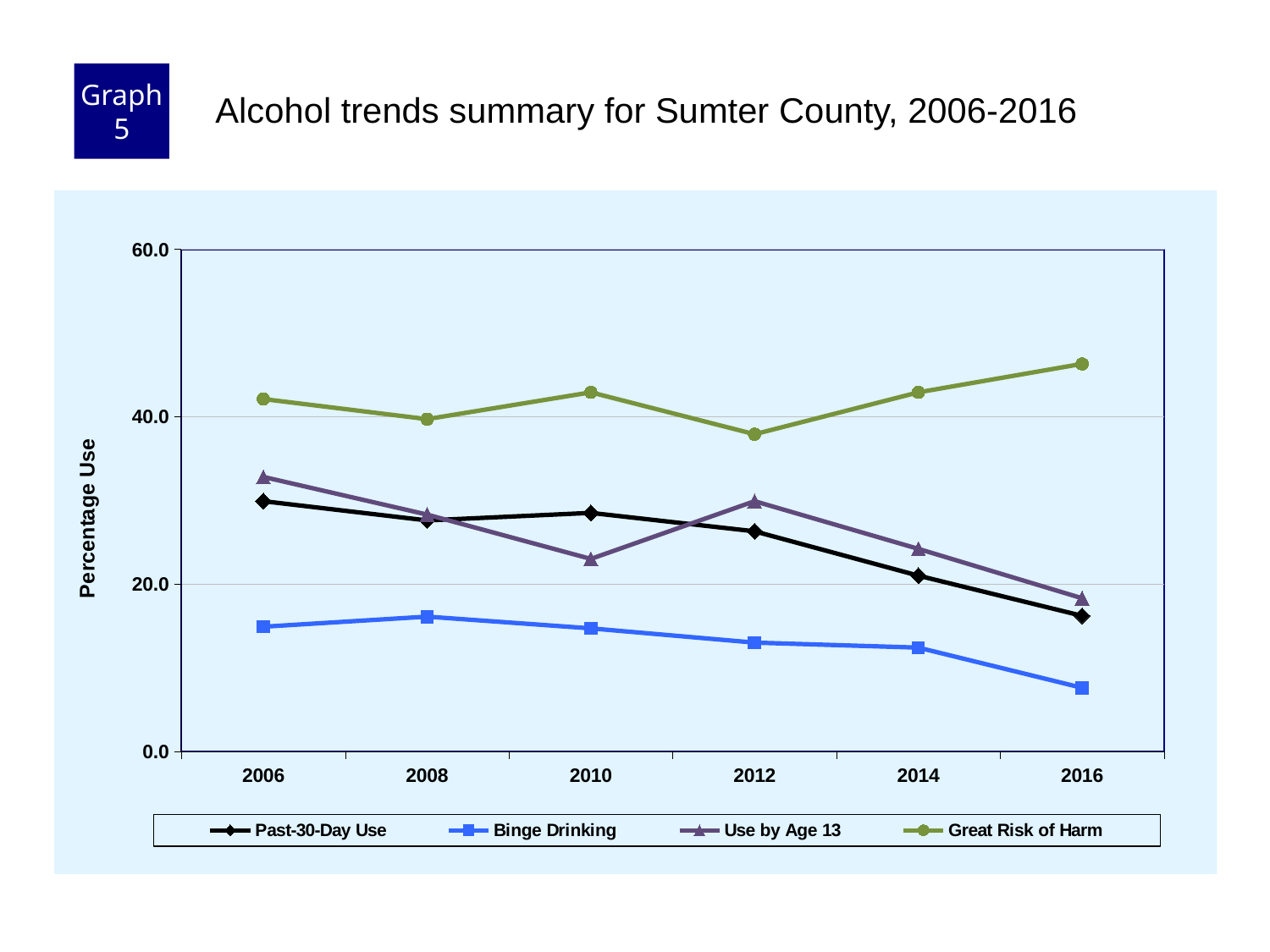
Is the value for Great Risk of Harm in 2016 greater or less than 40.0? greater Which series has the lowest value in 2016? Binge Drinking How many years are plotted along the x axis? 6 How many series does the legend list? 4 Is the value for Binge Drinking in 2016 greater or less than 20.0? less Which series has the highest value in 2016? Great Risk of Harm Does Binge Drinking rise or fall from 2008 to 2016? Fall What is the label on the y axis? Percentage Use What kind of chart is shown on the slide? Line chart Is the value for Past-30-Day Use in 2006 greater or less than 20.0? greater In 2010, which is higher: Past-30-Day Use or Use by Age 13? Past-30-Day Use